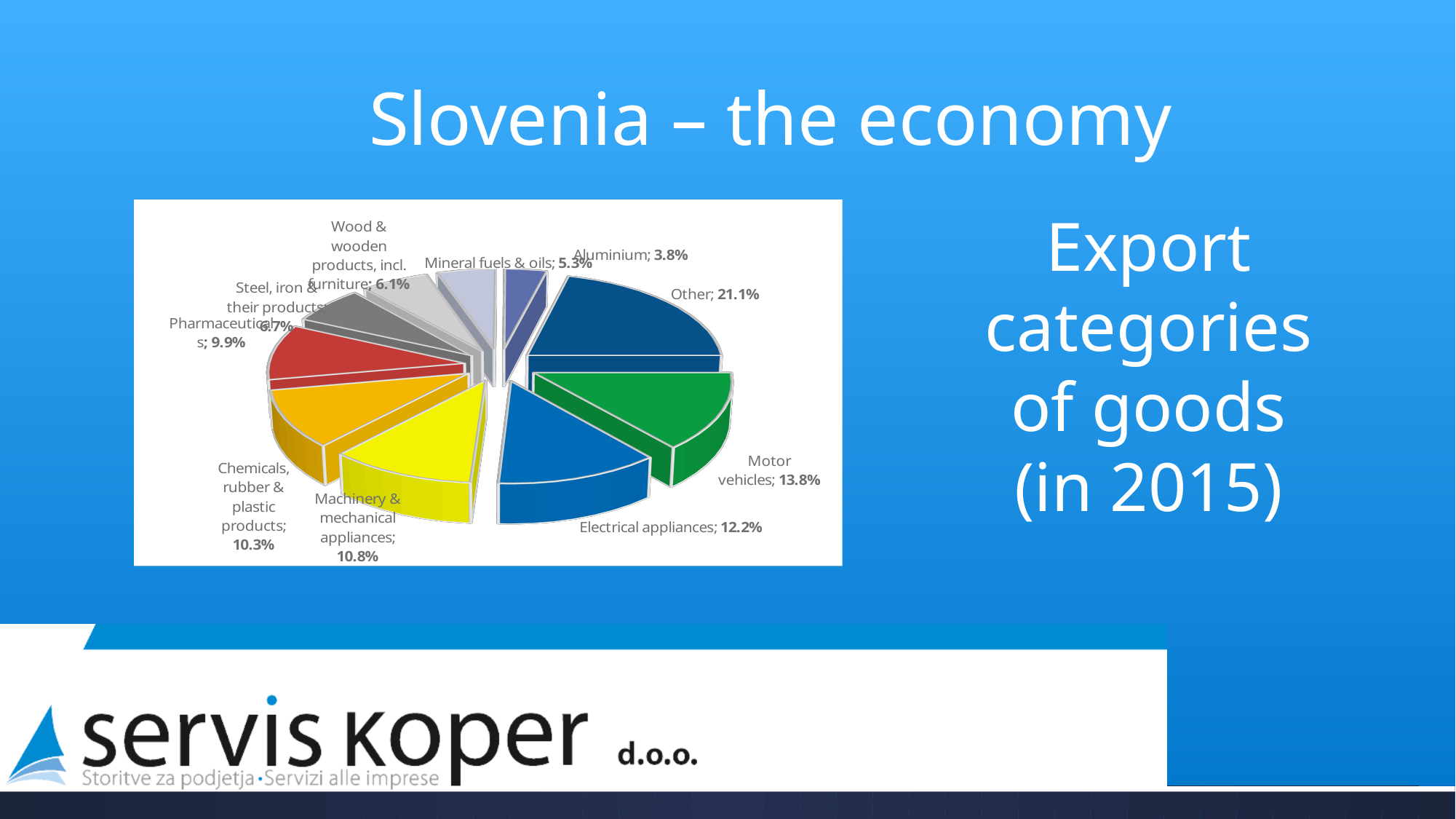
What year do the export categories in the chart refer to? 2015 What is the difference between the shares of Other and Motor vehicles? 7.3% What share of exports is labelled for Mineral fuels & oils? 5.3% What share of exports is labelled for Chemicals, rubber & plastic products? 10.3% Which category has the smallest share in the pie chart? Aluminium What share of exports is labelled for Pharmaceuticals? 9.9% Which has a larger share, Machinery & mechanical appliances or Wood & wooden products, incl. furniture? Machinery & mechanical appliances What share of exports is labelled for Electrical appliances? 12.2% What share of exports is labelled for Motor vehicles? 13.8% How many categories are shown in the pie chart? 10 What kind of chart is shown on the slide? pie chart Which category has the largest share in the pie chart? Other